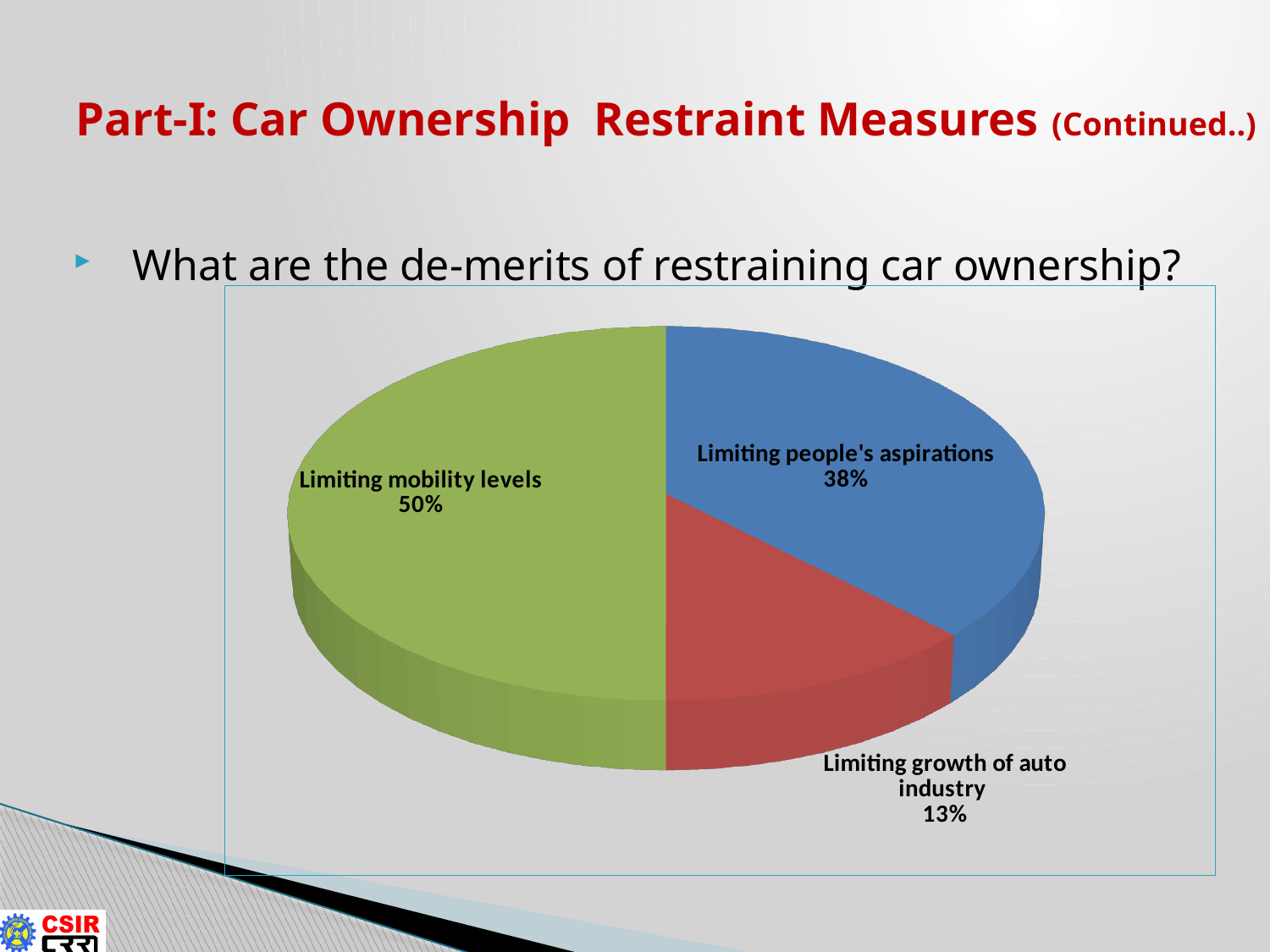
What is the difference in percentage points between "Limiting mobility levels" and "Limiting people's aspirations"? 12 Which slice of the pie is the smallest? Limiting growth of auto industry What share of the pie is labelled "Limiting mobility levels"? 50% How many slices does the pie chart have? 3 What colour is the "Limiting mobility levels" slice? green What kind of chart is shown on the slide? pie chart What is the difference in percentage points between "Limiting people's aspirations" and "Limiting growth of auto industry"? 25 Which slice of the pie is the largest? Limiting mobility levels Which is larger: the share for "Limiting people's aspirations" or the share for "Limiting growth of auto industry"? Limiting people's aspirations What share of the pie is labelled "Limiting growth of auto industry"? 13% What colour is the "Limiting growth of auto industry" slice? red What share of the pie is labelled "Limiting people's aspirations"? 38%